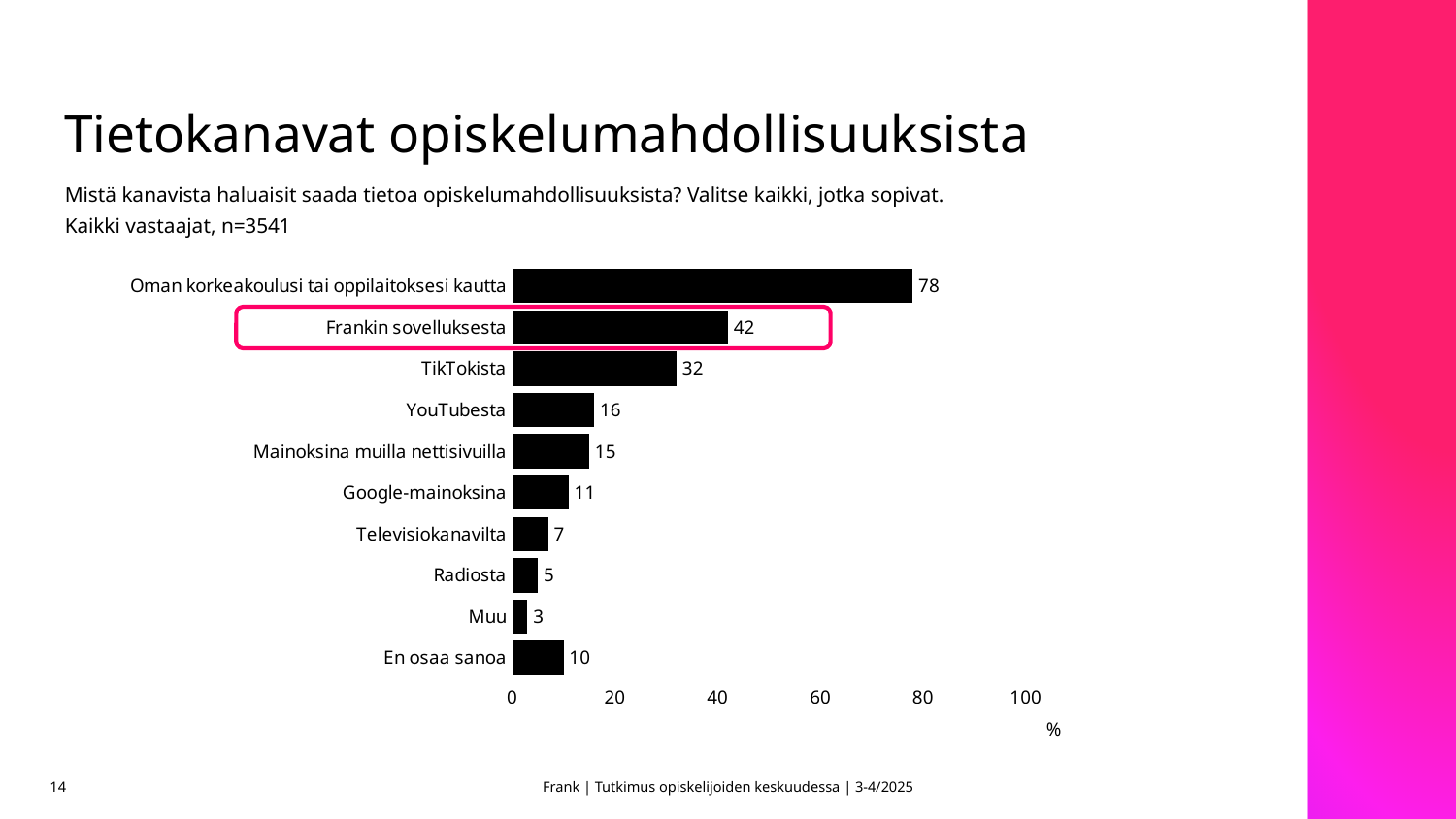
What is the value for "TikTokista"? 32 What is the value for "Radiosta"? 5 What is the value for "Frankin sovelluksesta"? 42 Is the value for "Google-mainoksina" greater or less than 20? less Which category is highlighted with a pink outline on the chart? Frankin sovelluksesta How many categories are shown in the chart? 10 Which category has the lowest value? Muu What kind of chart is shown on the slide? bar chart What is the value for "En osaa sanoa"? 10 What is the difference between the values for "Oman korkeakoulusi tai oppilaitoksesi kautta" and "Frankin sovelluksesta"? 36 Which category has the highest value? Oman korkeakoulusi tai oppilaitoksesi kautta Which is larger, the value for "YouTubesta" or "Mainoksina muilla nettisivuilla"? YouTubesta